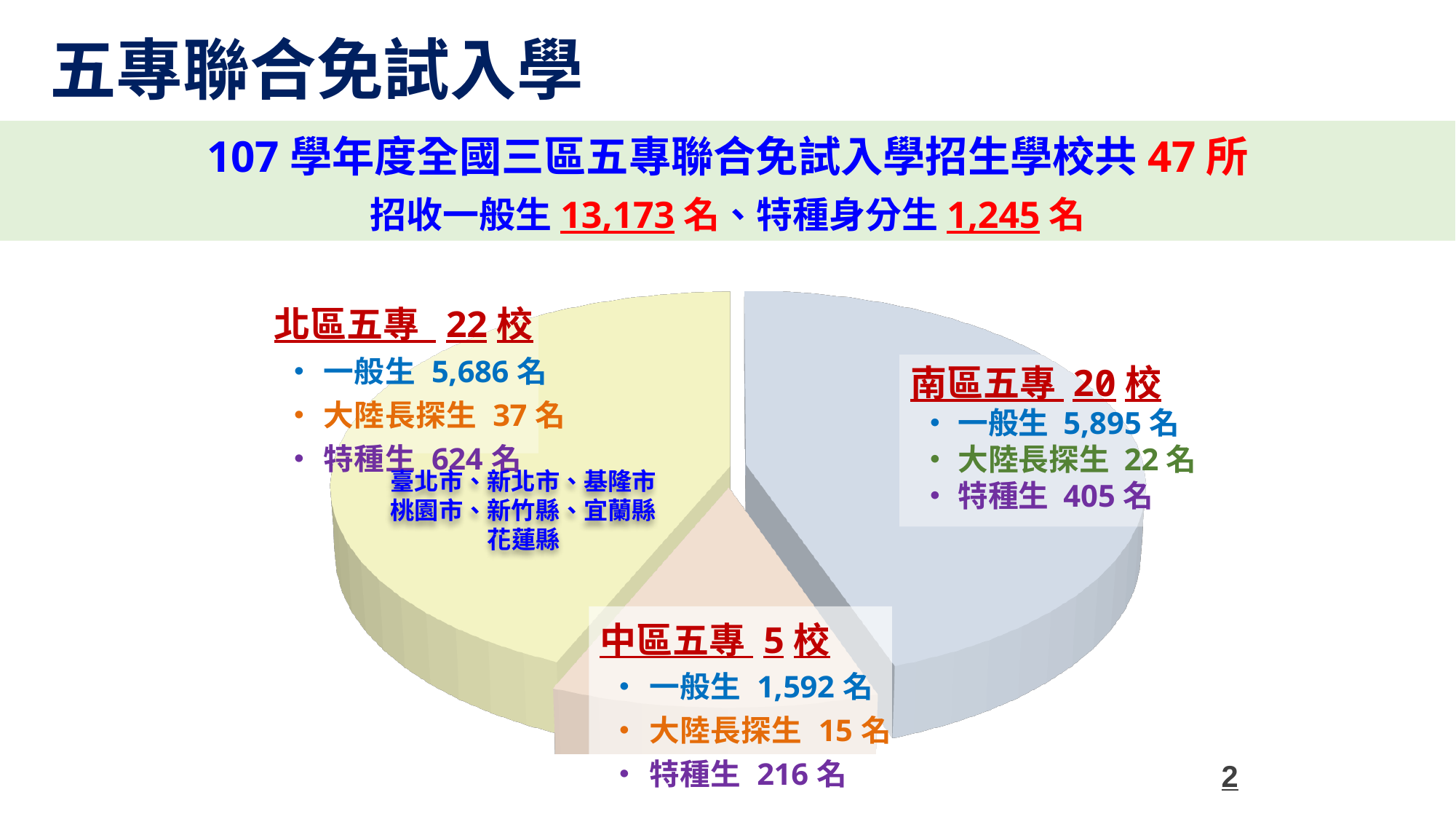
How many 大陸長探生 does 中區五專 admit? 15 名 Which region's slice is the smallest in the pie chart? 中區五專 What kind of chart is shown on the slide? pie chart Which admits more 一般生, 北區五專 or 南區五專? 南區五專 What is the difference between the 特種生 of 北區五專 and 南區五專? 219 How many schools does 北區五專 have according to the chart label? 22 校 How many 特種生 does 中區五專 admit? 216 名 Which region has the fewest schools? 中區五專 How many 一般生 does 南區五專 admit? 5,895 名 What is the total number of schools across the three regions shown? 47 Which region has the most schools? 北區五專 How many regions (slices) does the pie chart show? 3